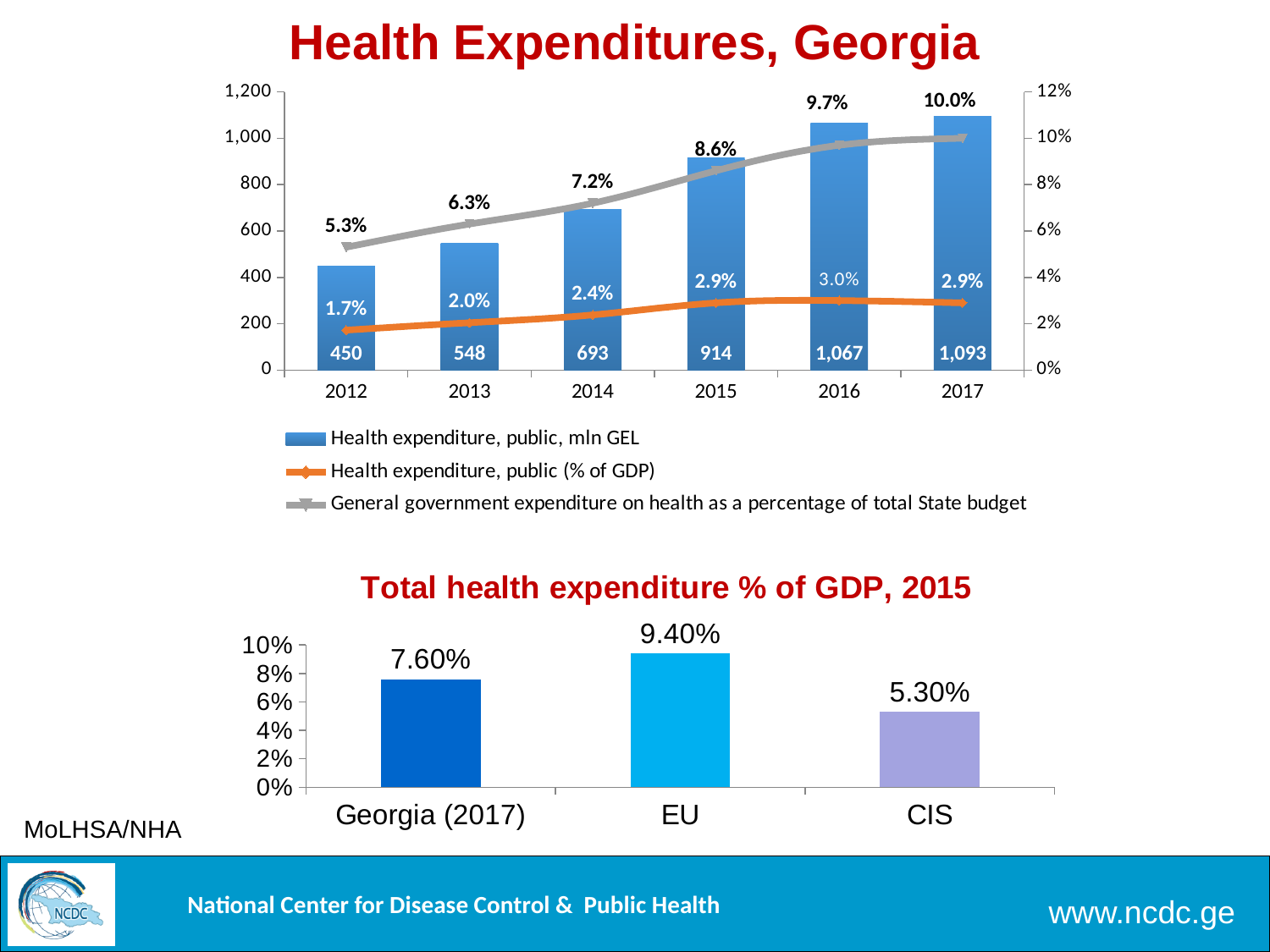
What kind of chart is the 'Total health expenditure % of GDP, 2015' chart? bar chart In the 'Health Expenditures, Georgia' chart, which year has the highest public health expenditure in mln GEL? 2017 In the 'Total health expenditure % of GDP, 2015' chart, what is the difference between the EU and Georgia (2017) values? 1.80% In the 'Health Expenditures, Georgia' chart, by how many mln GEL did public health expenditure increase from 2012 to 2017? 643 In the 'Health Expenditures, Georgia' chart, which year has the lowest general government expenditure on health as a percentage of total State budget? 2012 In the 'Health Expenditures, Georgia' chart, what was public health expenditure as % of GDP in 2016? 3.0% In the 'Health Expenditures, Georgia' chart, what was general government expenditure on health as a percentage of total State budget in 2015? 8.6% In the 'Total health expenditure % of GDP, 2015' chart, what is the value for the EU? 9.40% In the 'Total health expenditure % of GDP, 2015' chart, which category has the lowest value? CIS In the 'Health Expenditures, Georgia' chart, does public health expenditure in mln GEL rise or fall from 2012 to 2017? rise In the 'Health Expenditures, Georgia' chart, what was public health expenditure in mln GEL in 2014? 693 In the 'Health Expenditures, Georgia' chart, how many series does the legend list? 3